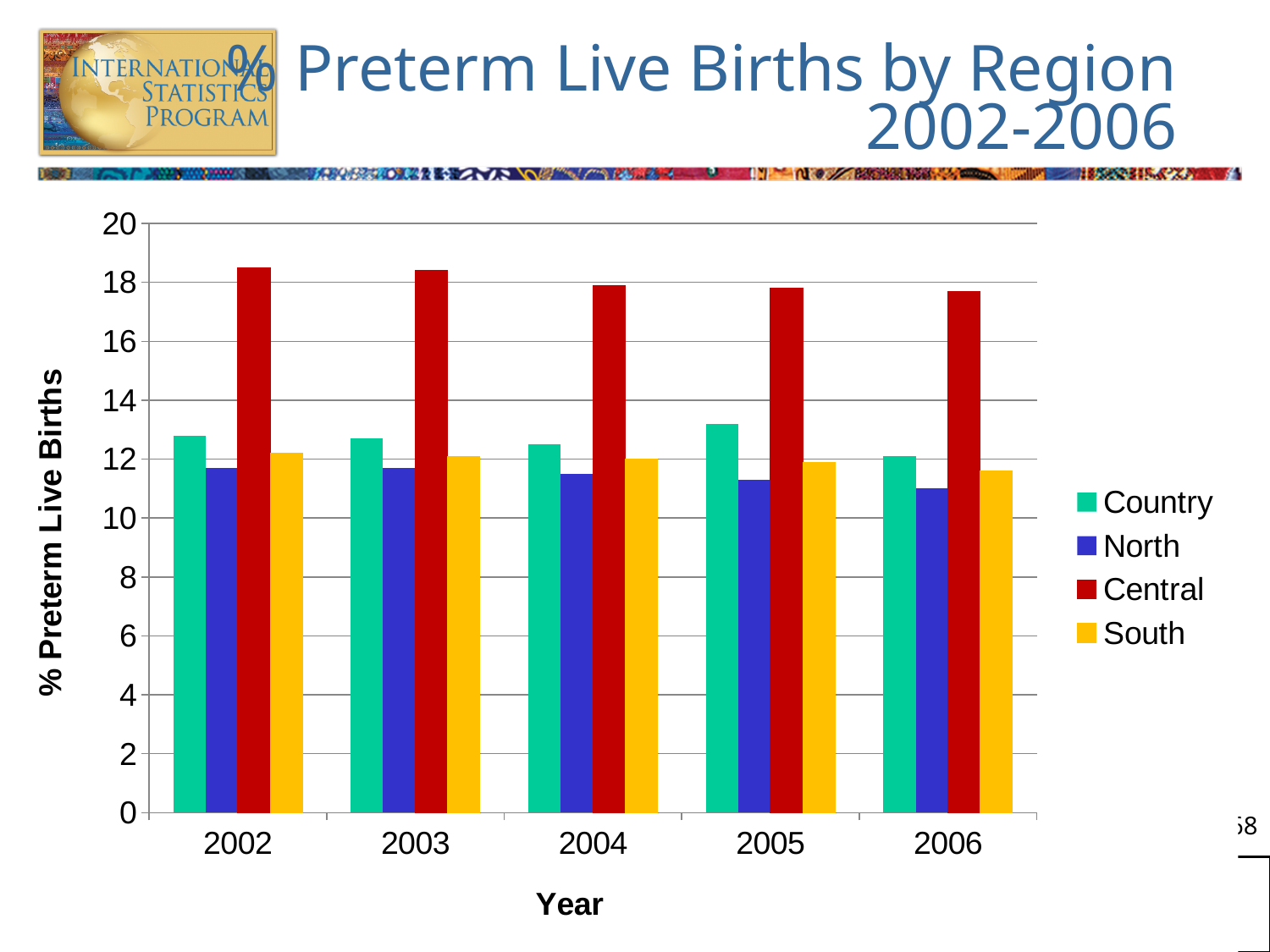
Is the value for North in 2005 greater or less than 12? less Is the value for Central in 2002 greater or less than 18? greater Do the values for Central rise or fall from 2002 to 2006? fall Which series has the lowest % preterm live births in 2006? North What is the label of the y axis? % Preterm Live Births How many series does the legend list? 4 Which region has the highest % preterm live births in 2002? Central Is the value for Central in 2006 greater or less than 18? less What kind of chart is shown on the slide? bar chart How many years are shown on the x axis? 5 In 2005, which is larger: the value for Country or the value for South? Country